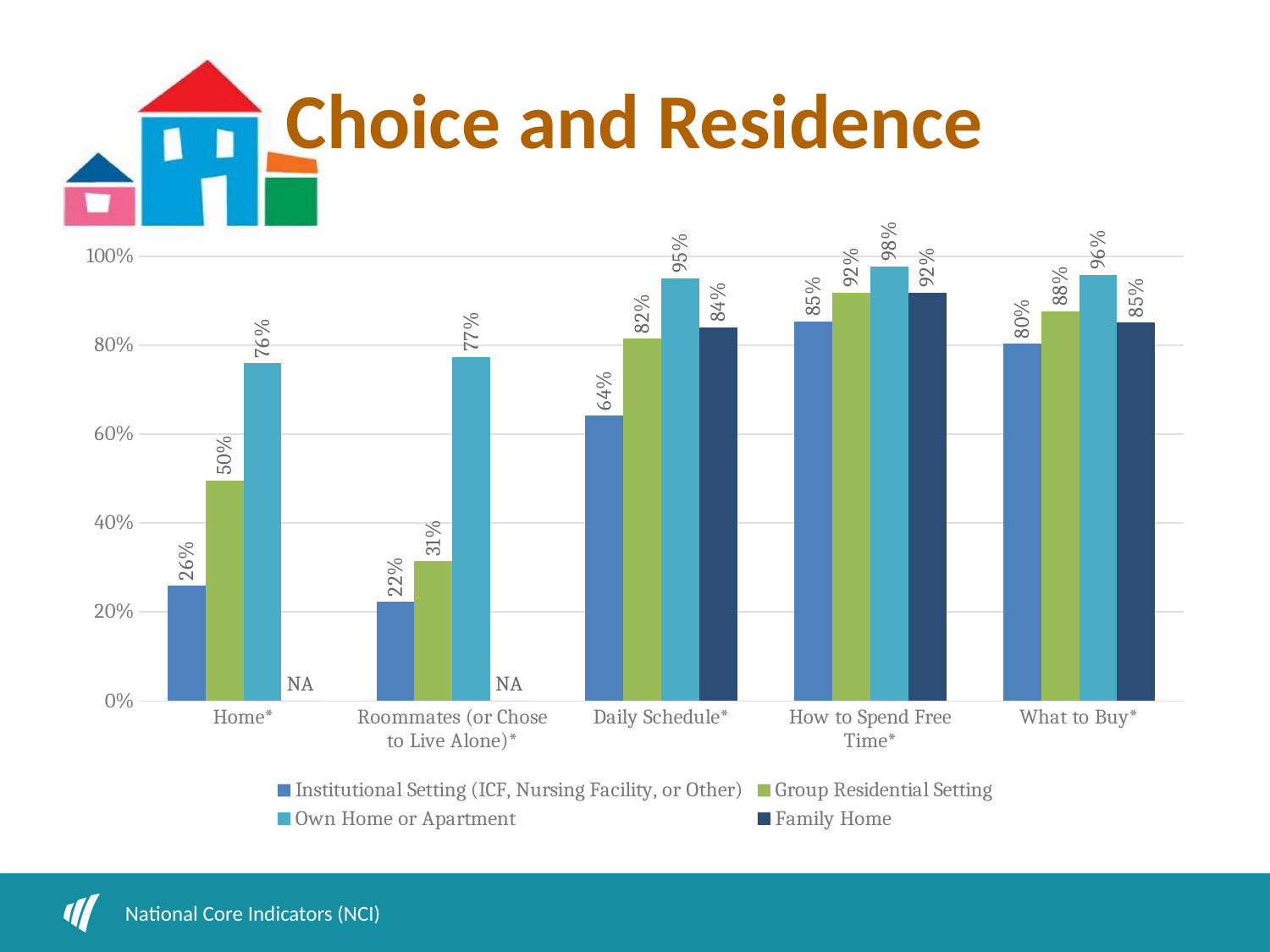
Which series has the lowest value in the Home* category? Institutional Setting (ICF, Nursing Facility, or Other) Which series has the highest value in the What to Buy* category? Own Home or Apartment What is the value for Own Home or Apartment in the Home* category? 76% Which is larger: Group Residential Setting in Daily Schedule* or Family Home in Daily Schedule*? Family Home in Daily Schedule* How many categories are shown on the x axis? 5 What is the difference between Group Residential Setting and Institutional Setting (ICF, Nursing Facility, or Other) in the Home* category? 24% How many series does the legend list? 4 What is the title of the slide? Choice and Residence What is the value for Institutional Setting (ICF, Nursing Facility, or Other) in the Daily Schedule* category? 64% What kind of chart is shown on the slide? Bar chart What is shown for Family Home in the Roommates (or Chose to Live Alone)* category? NA What is the value for Family Home in the How to Spend Free Time* category? 92%